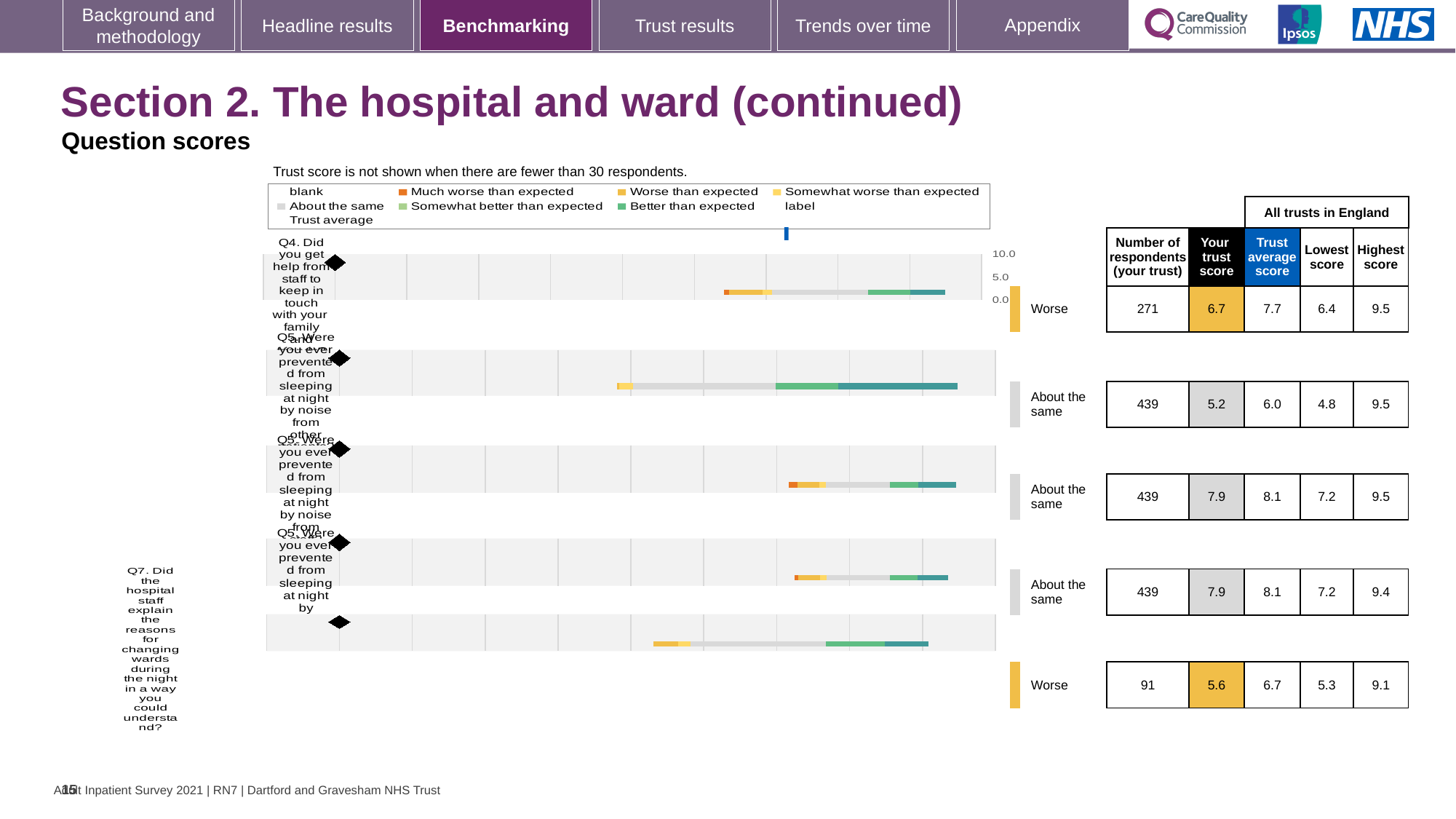
What kind of chart is used to show the question scores on this slide? bar chart What is the trust score for Q7 (explaining reasons for changing wards during the night)? 5.6 How many question rows are plotted in the chart? 5 How many respondents answered Q4 at this trust? 271 How many respondents answered Q7 at this trust? 91 What benchmark category is shown for Q4? Worse Which question has the lowest trust score on this slide? Q5 (prevented from sleeping at night by noise from other patients/staff), with a trust score of 5.2 For Q4, which is larger: the trust score or the trust average score? trust average score What is the trust average score for Q4? 7.7 What is the trust score for Q4 (help from staff to keep in touch with family)? 6.7 For Q4, what is the difference between the trust average score (7.7) and the trust score (6.7)? 1.0 What is the highest score across all trusts in England for Q7? 9.1